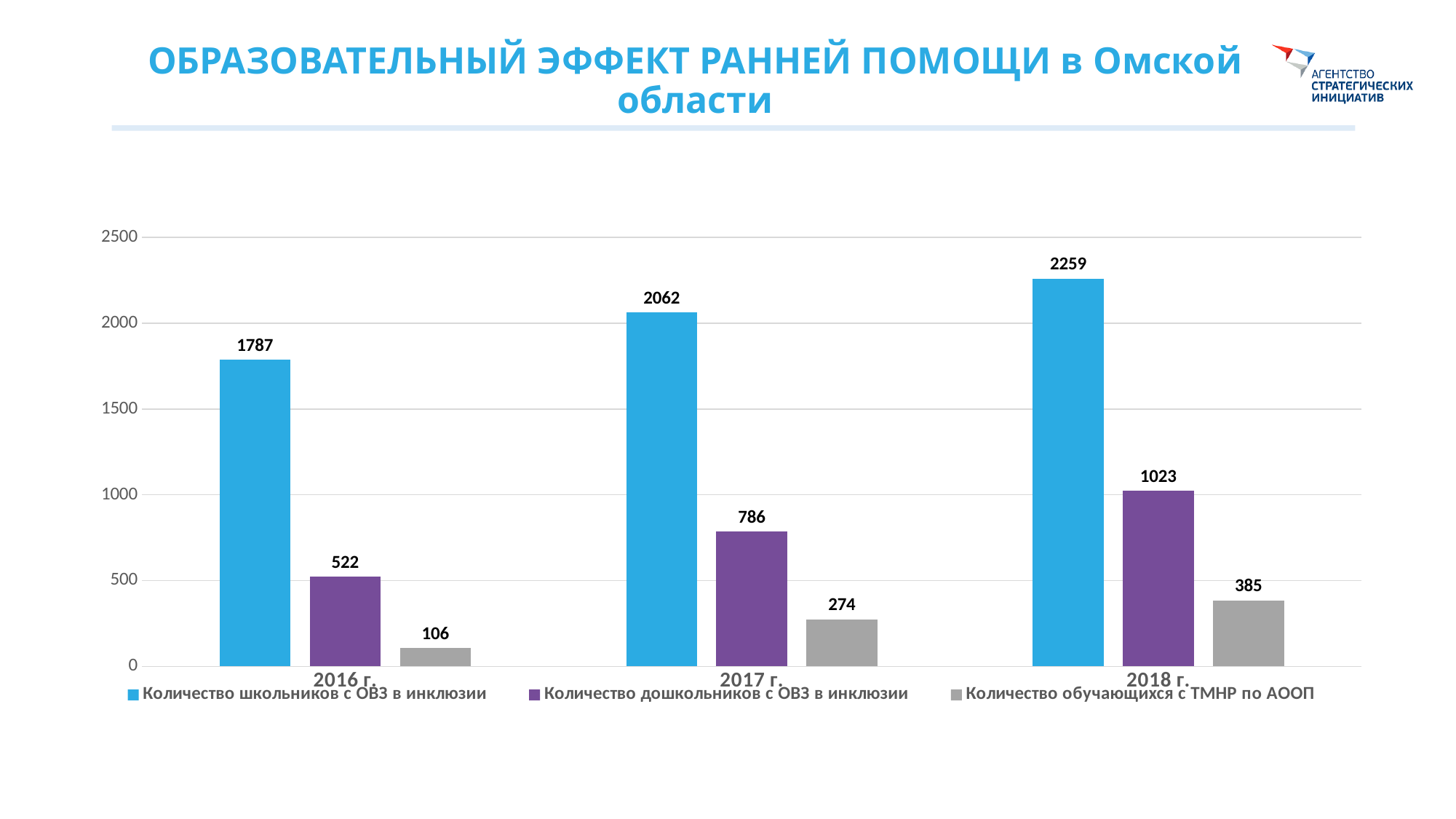
Which is larger: 'Количество дошкольников с ОВЗ в инклюзии' in 2017 г. or 'Количество обучающихся с ТМНР по АООП' in 2018 г.? Количество дошкольников с ОВЗ в инклюзии in 2017 г. Does 'Количество дошкольников с ОВЗ в инклюзии' rise or fall from 2016 г. to 2018 г.? rise How many years are shown on the x axis? 3 Is the value for 'Количество дошкольников с ОВЗ в инклюзии' in 2018 г. greater or less than 1000? greater How many series does the legend list? 3 What is the value for 'Количество дошкольников с ОВЗ в инклюзии' in 2018 г.? 1023 In which year is 'Количество школьников с ОВЗ в инклюзии' highest? 2018 г. What is the difference between 'Количество школьников с ОВЗ в инклюзии' in 2018 г. and in 2017 г.? 197 What is the value for 'Количество школьников с ОВЗ в инклюзии' in 2016 г.? 1787 What kind of chart is shown on the slide? bar chart What is the value for 'Количество обучающихся с ТМНР по АООП' in 2017 г.? 274 In which year is 'Количество обучающихся с ТМНР по АООП' lowest? 2016 г.